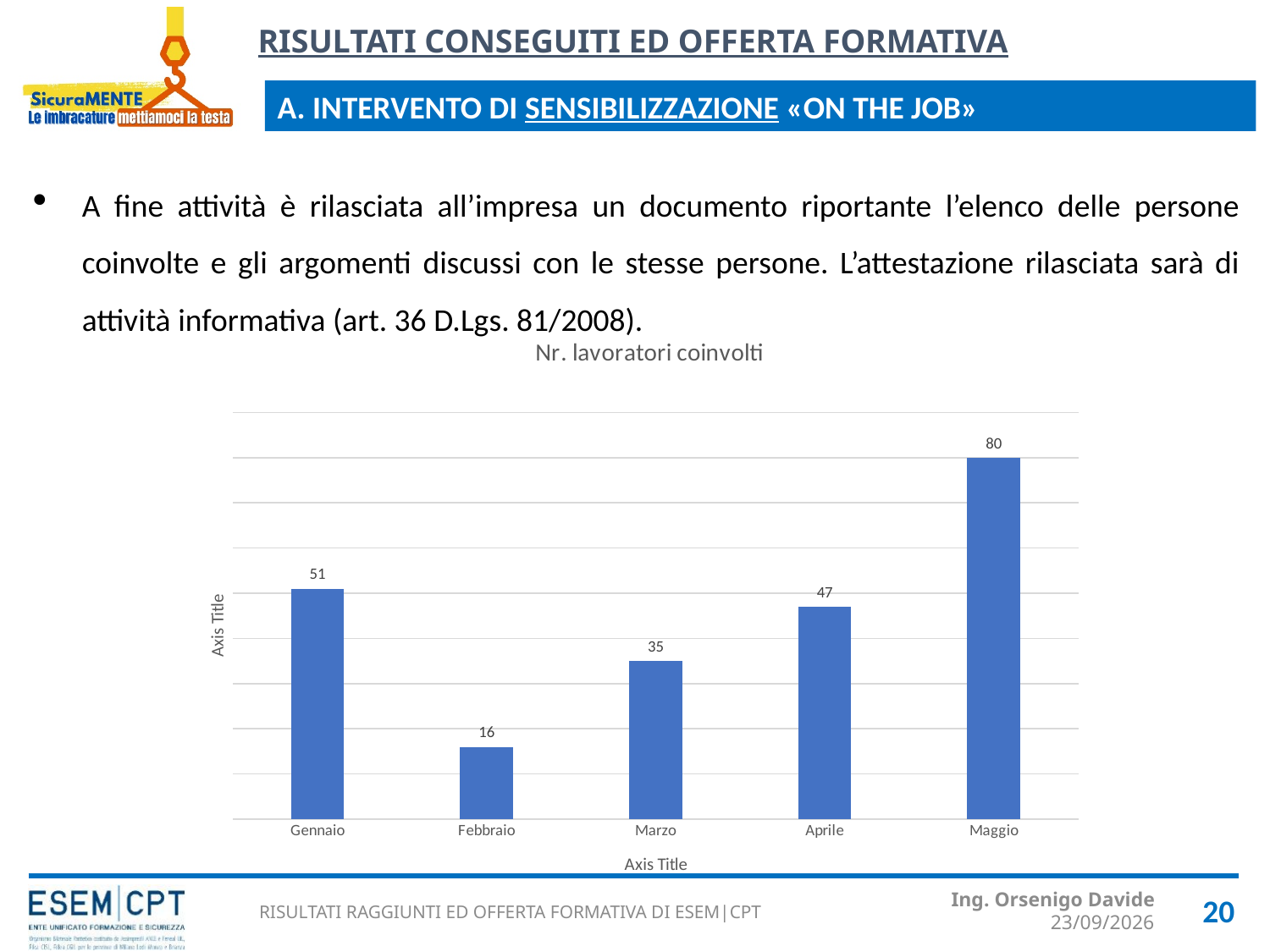
What is the difference between the values for Maggio and Gennaio? 29 What kind of chart is shown on the slide? Bar chart What is the title of the chart? Nr. lavoratori coinvolti How many categories are shown on the x axis? 5 Which is larger, the value for Gennaio or the value for Aprile? Gennaio What is the value for Febbraio? 16 Which month has the lowest number of workers involved? Febbraio What is the value for Aprile? 47 Which month has the highest number of workers involved? Maggio What is the value for Gennaio? 51 What is the value for Marzo? 35 What is the value for Maggio? 80